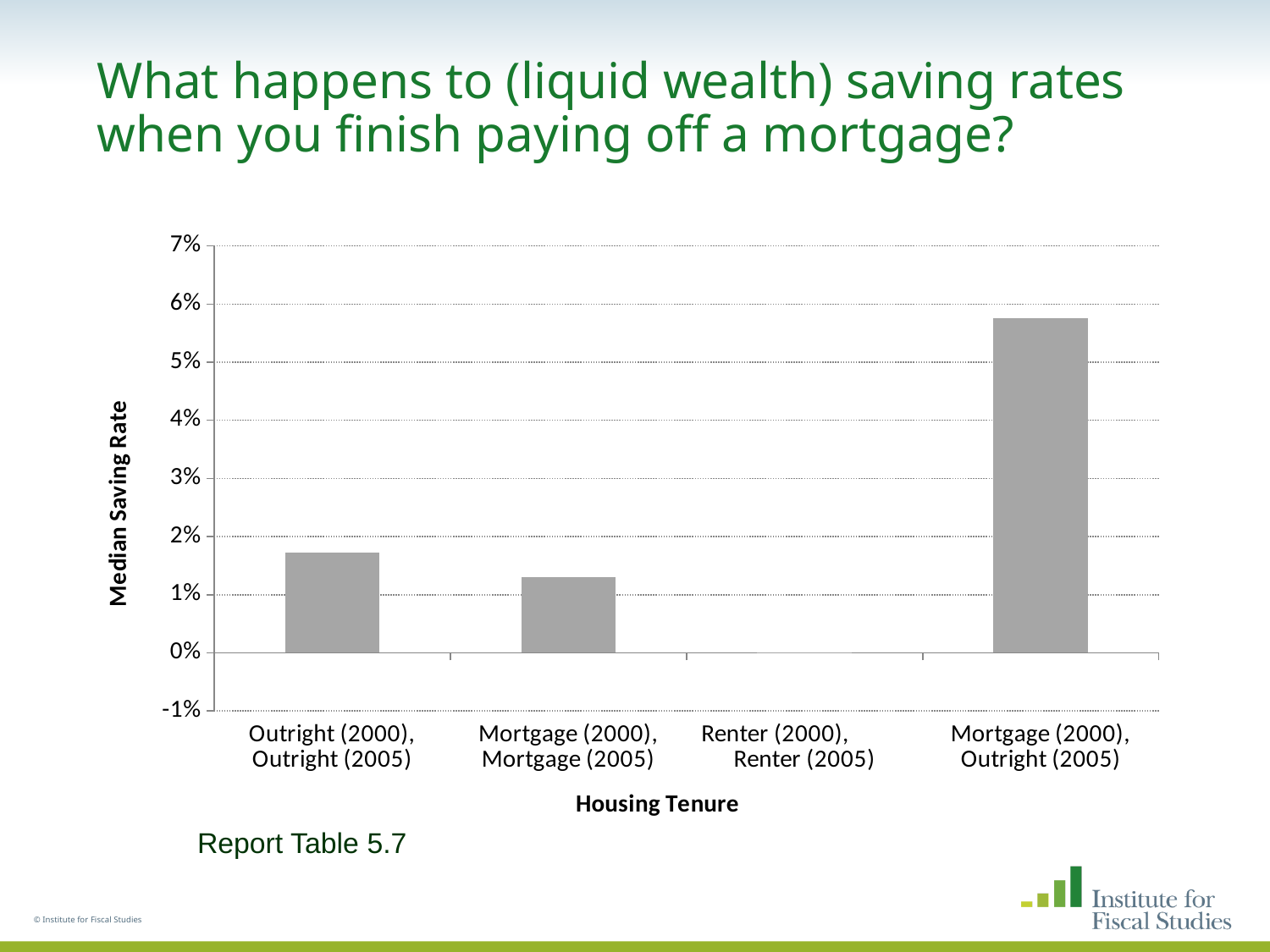
What is the title of the y axis of the chart? Median Saving Rate Is the median saving rate for Mortgage (2000), Outright (2005) greater or less than 6%? less Which housing tenure category has the highest median saving rate? Mortgage (2000), Outright (2005) What is the title of the x axis of the chart? Housing Tenure How many housing tenure categories are shown on the x axis? 4 Which housing tenure category has the lowest median saving rate? Renter (2000), Renter (2005) Is the median saving rate for Outright (2000), Outright (2005) greater or less than 1%? greater Which has a higher median saving rate: Outright (2000), Outright (2005) or Mortgage (2000), Mortgage (2005)? Outright (2000), Outright (2005) Is the median saving rate for Mortgage (2000), Outright (2005) greater or less than 5%? greater What kind of chart is shown on the slide? bar chart Which has a higher median saving rate: Mortgage (2000), Outright (2005) or Outright (2000), Outright (2005)? Mortgage (2000), Outright (2005)